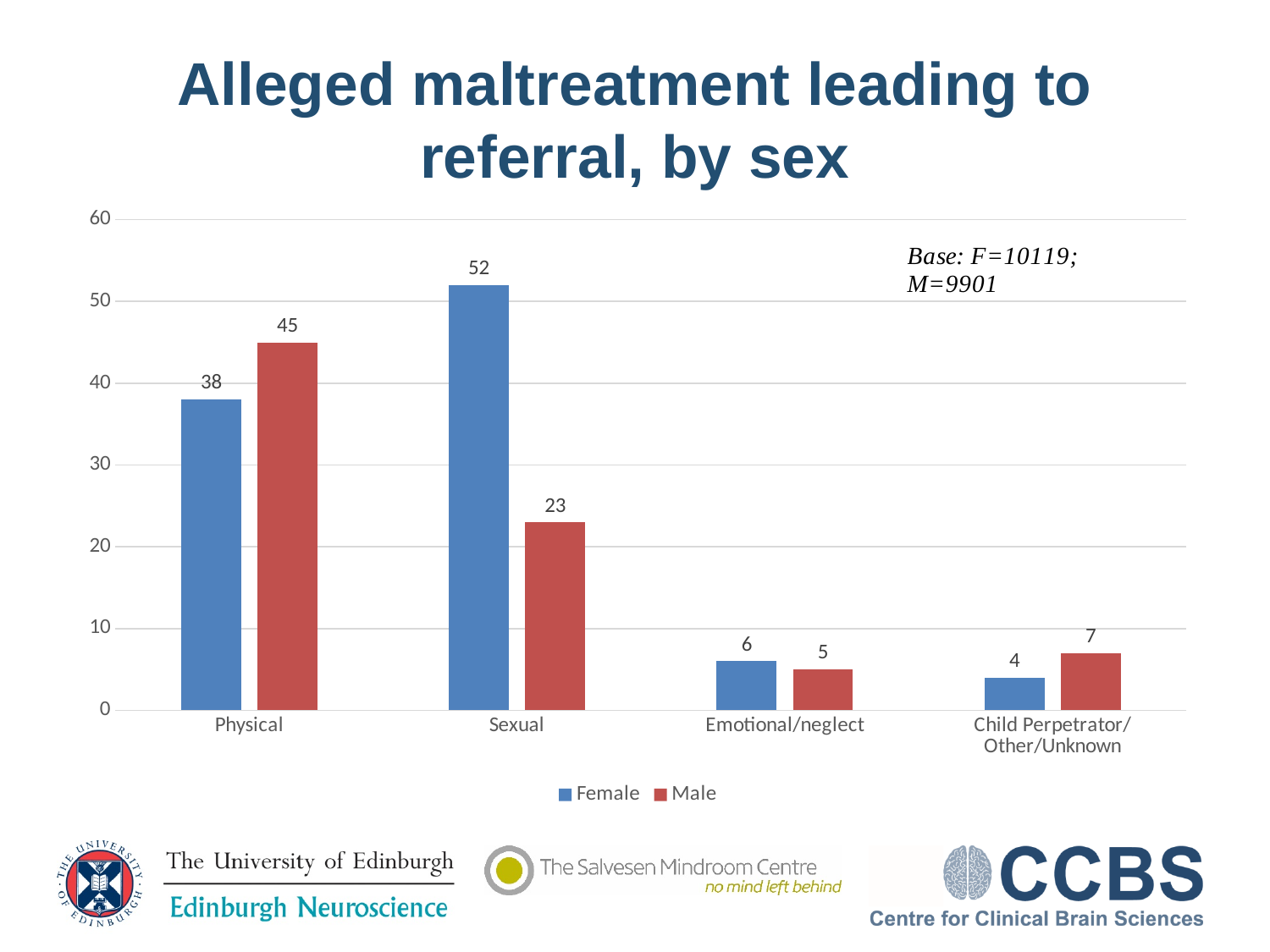
Which category has the lowest Female value? Child Perpetrator/Other/Unknown What is the Female value for Child Perpetrator/Other/Unknown? 4 Which category has the highest Male value? Physical What is the title of the chart? Alleged maltreatment leading to referral, by sex What is the Male value for Physical? 45 Which is larger for Physical, the Female value or the Male value? Male How many series does the legend list? 2 How many categories are shown on the x axis? 4 What kind of chart is shown on the slide? bar chart What is the difference between the Female and Male values for Sexual? 29 Is the Male value for Sexual greater or less than 30? less What is the Female value for Sexual? 52